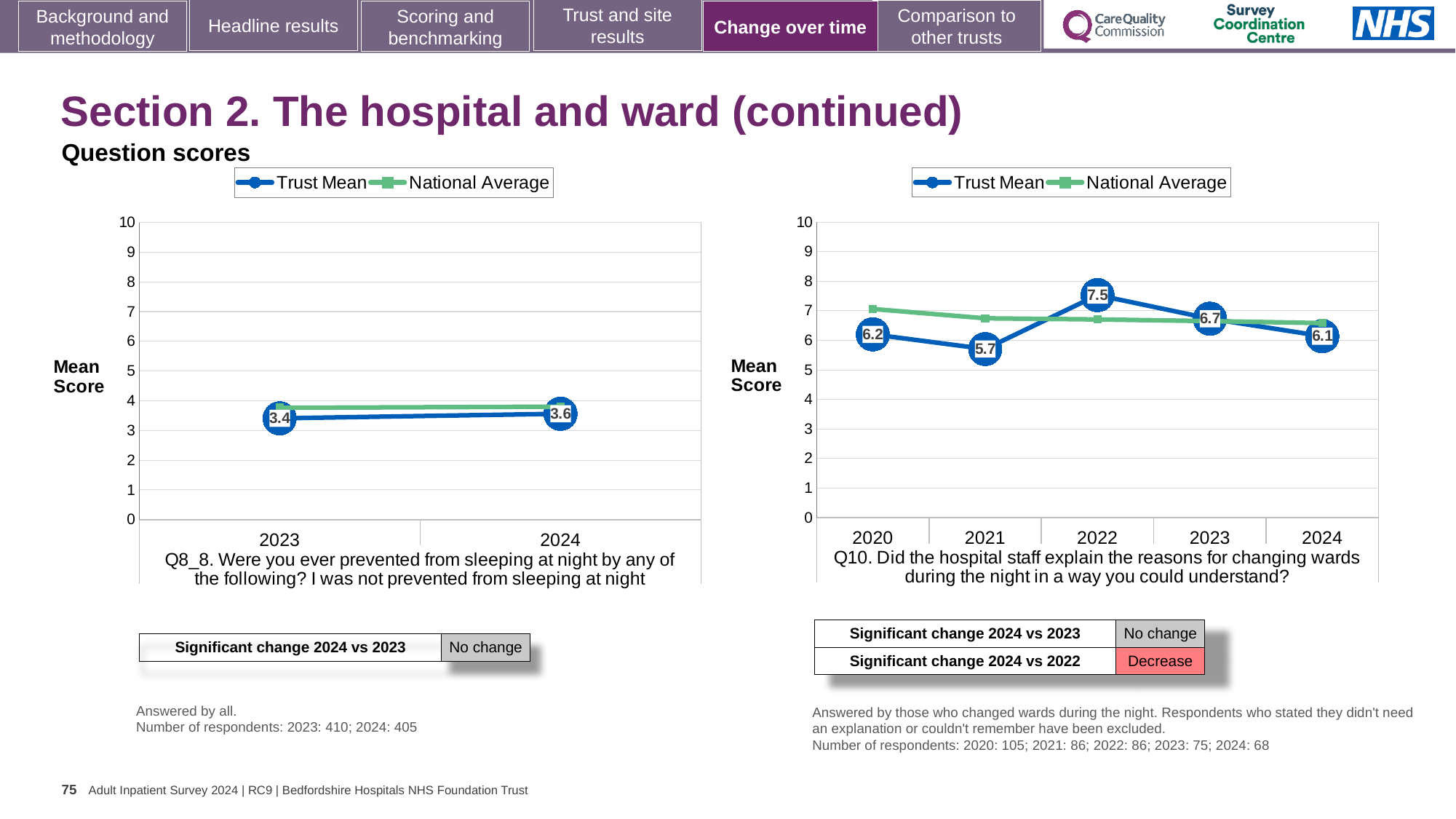
In the Q10 chart on the right, which year has the lowest Trust Mean? 2021 In the Q10 chart on the right, which year has the highest Trust Mean? 2022 In the Q8_8 chart on the left, what is the Trust Mean for 2023? 3.4 In the Q8_8 chart on the left, how many years are shown on the x axis? 2 In the Q10 chart on the right, what is the Trust Mean for 2021? 5.7 In the Q8_8 chart on the left, does the Trust Mean rise or fall from 2023 to 2024? rise In the Q8_8 chart on the left, what is the Trust Mean for 2024? 3.6 In the Q10 chart on the right, is the Trust Mean higher in 2020 or in 2023? 2023 In the Q10 chart on the right, what is the Trust Mean for 2022? 7.5 In the Q10 chart on the right, is the National Average for 2020 greater or less than 6? greater How many series does the legend of the Q10 chart on the right list? 2 In the Q10 chart on the right, what is the difference between the Trust Mean in 2022 and in 2024? 1.4